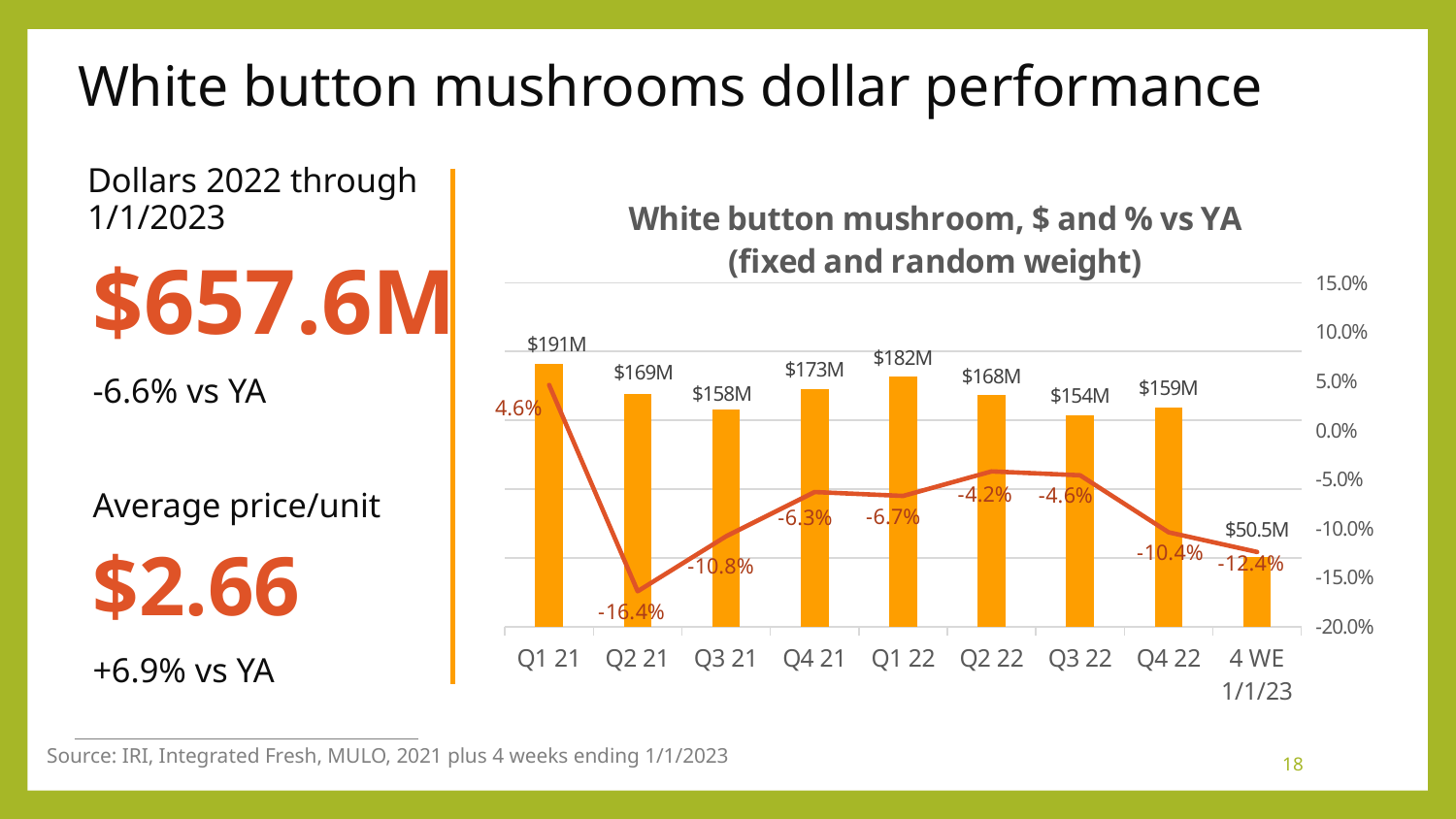
What is the dollar value for Q1 21? $191M What is the % vs YA value for Q4 22? -10.4% What is the difference in dollar value between Q1 21 and Q2 21? $22M Does the % vs YA line rise or fall from Q2 21 to Q2 22? Rise Which is larger, the dollar value for Q4 21 or Q1 22? Q1 22 What is the dollar value for Q1 22? $182M What kind of chart is this? Combination bar and line chart What is the % vs YA value for Q2 21? -16.4% Which period has the highest dollar value? Q1 21 How many periods are shown on the x axis? 9 Which period has the lowest % vs YA value? Q2 21 What is the title of the chart? White button mushroom, $ and % vs YA (fixed and random weight)